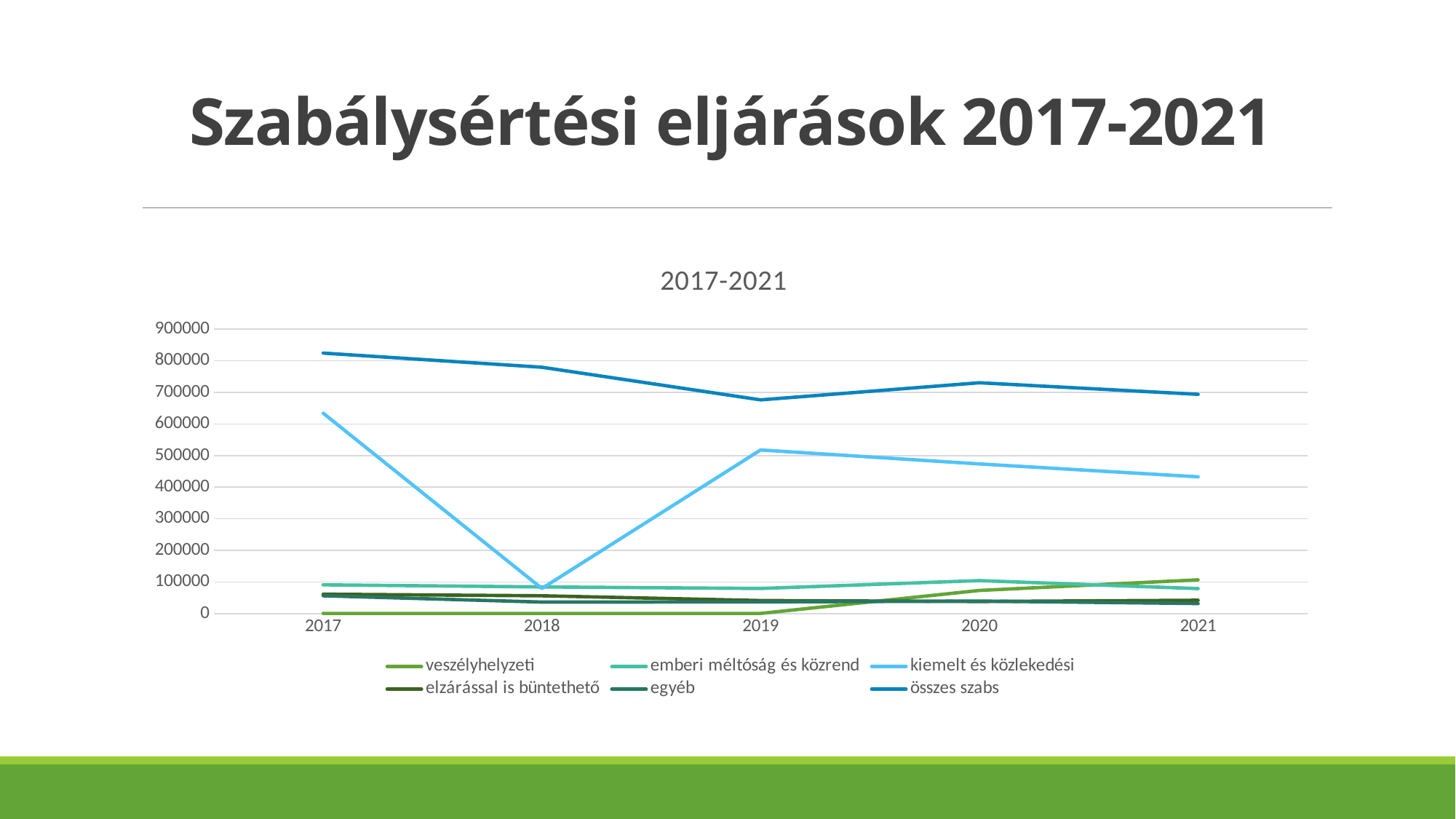
What kind of chart is shown on the slide? line chart Is the value for összes szabs in 2017 greater or less than 800000? greater In which year is the kiemelt és közlekedési series at its lowest? 2018 How many years are plotted along the x axis of the chart? 5 Does the veszélyhelyzeti series rise or fall from 2019 to 2021? rise Does the összes szabs series rise or fall from 2017 to 2019? fall How many series does the chart legend list? 6 Is the value for kiemelt és közlekedési in 2021 greater or less than 400000? greater In 2019, which series is higher: összes szabs or kiemelt és közlekedési? összes szabs Is the value for kiemelt és közlekedési in 2018 greater or less than 200000? less What is the title of the chart? 2017-2021 In which year is the összes szabs series at its highest? 2017